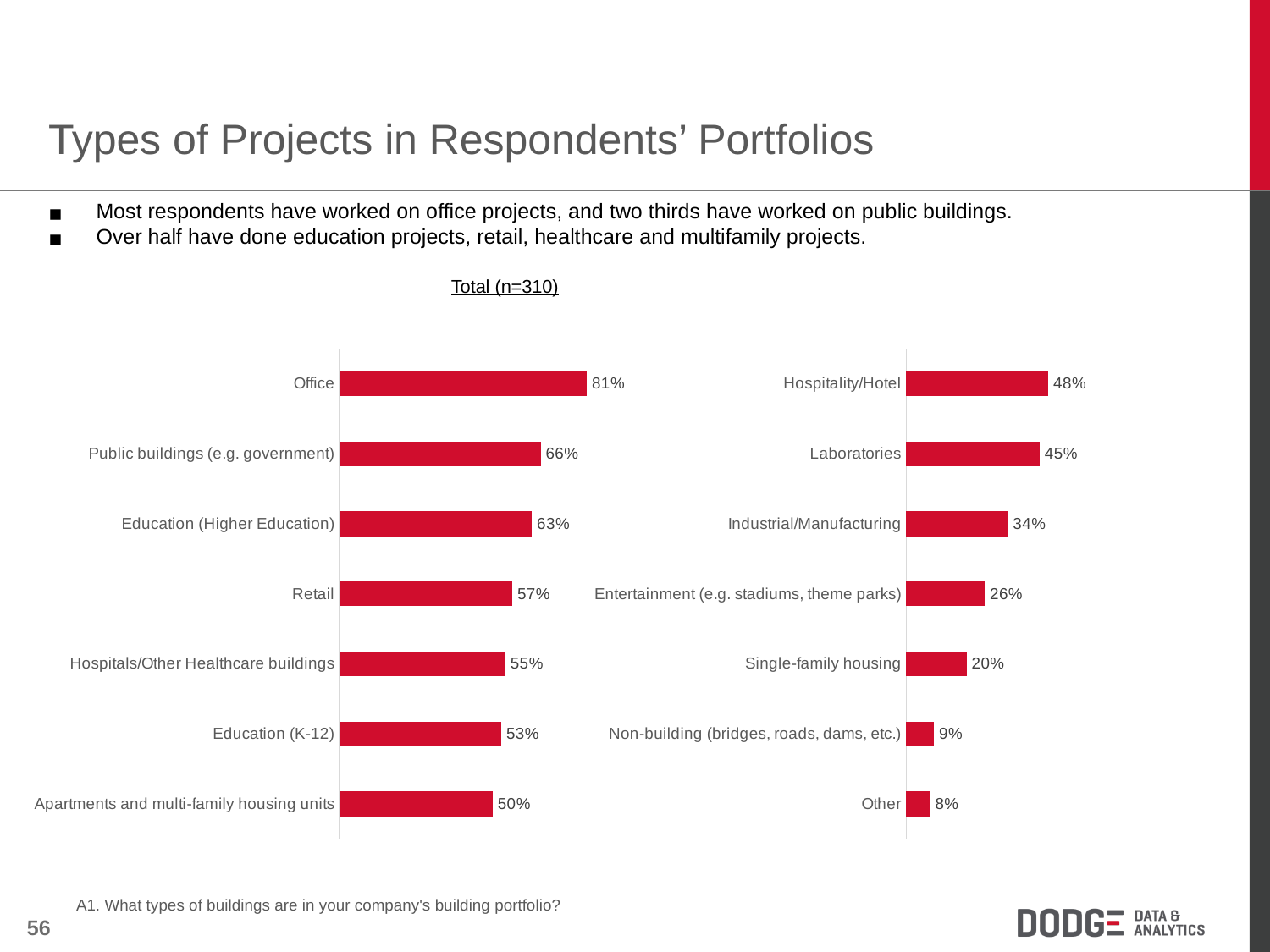
In the right chart, which is larger: Industrial/Manufacturing or Entertainment (e.g. stadiums, theme parks)? Industrial/Manufacturing How many categories are shown in the right chart? 7 How many categories are shown in the left chart? 7 In the left chart, what percentage of respondents have Office projects in their portfolio? 81% In the right chart, what is the difference between Hospitality/Hotel and Single-family housing? 28% In the left chart, what is the difference between the values for Office and Retail? 24% What is the sample size shown in the chart heading? n=310 In the right chart, which category has the lowest value? Other In the left chart, which category has the highest value? Office In the left chart, what is the value for Education (K-12)? 53% In the right chart, what is the value for Laboratories? 45% What type of chart is used on this slide? Bar chart